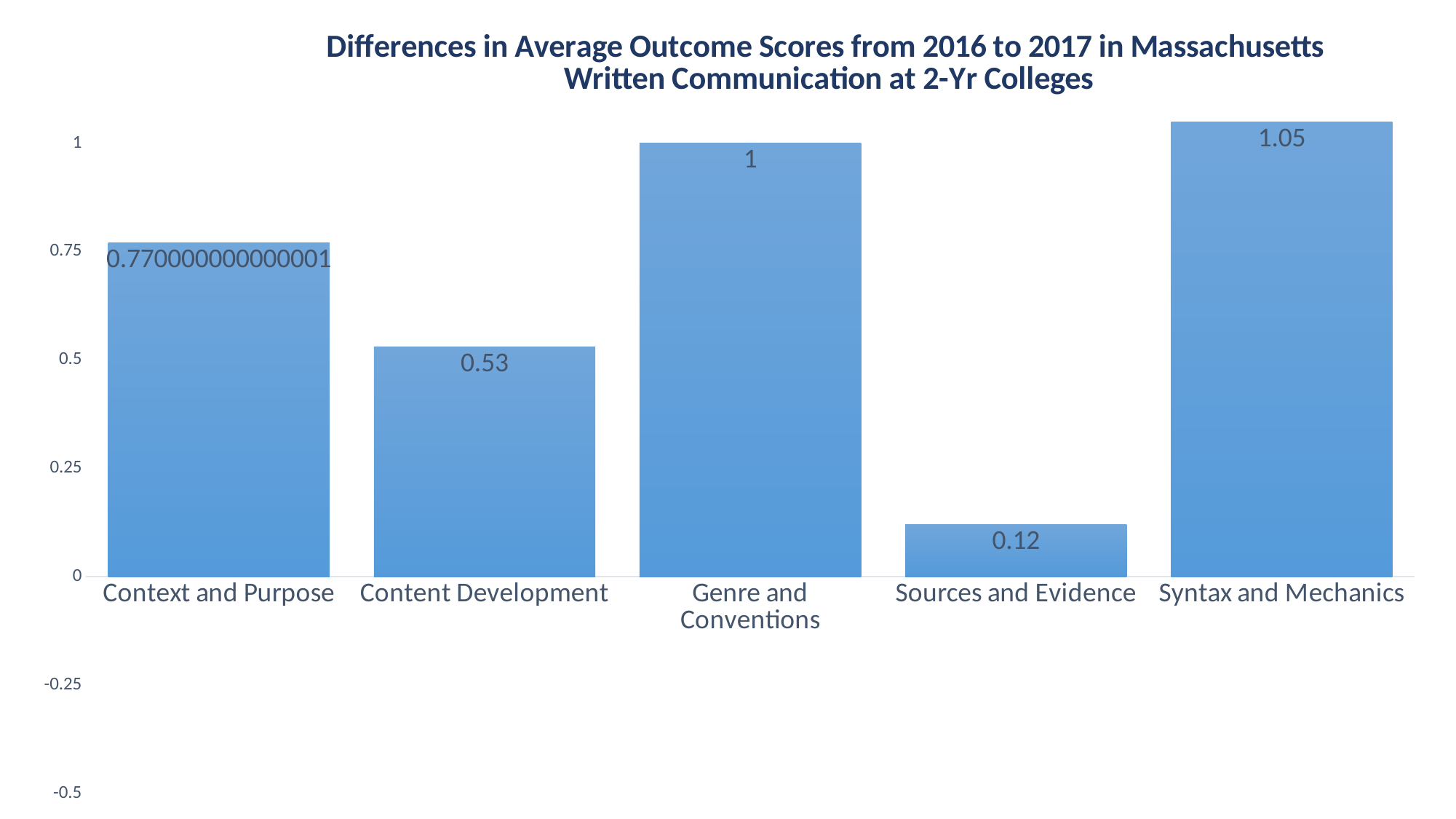
What is the difference between the values for Syntax and Mechanics and Content Development? 0.52 What is the value for Sources and Evidence? 0.12 Is the value for Context and Purpose greater or less than 0.5? greater Which category has the lowest value? Sources and Evidence What is the value for Content Development? 0.53 What kind of chart is shown on the slide? bar chart What is the title of the chart? Differences in Average Outcome Scores from 2016 to 2017 in Massachusetts Written Communication at 2-Yr Colleges How many categories are shown on the x axis? 5 Which category has the highest value? Syntax and Mechanics What is the value for Genre and Conventions? 1 What is the value for Syntax and Mechanics? 1.05 Which is larger, the value for Content Development or the value for Genre and Conventions? Genre and Conventions